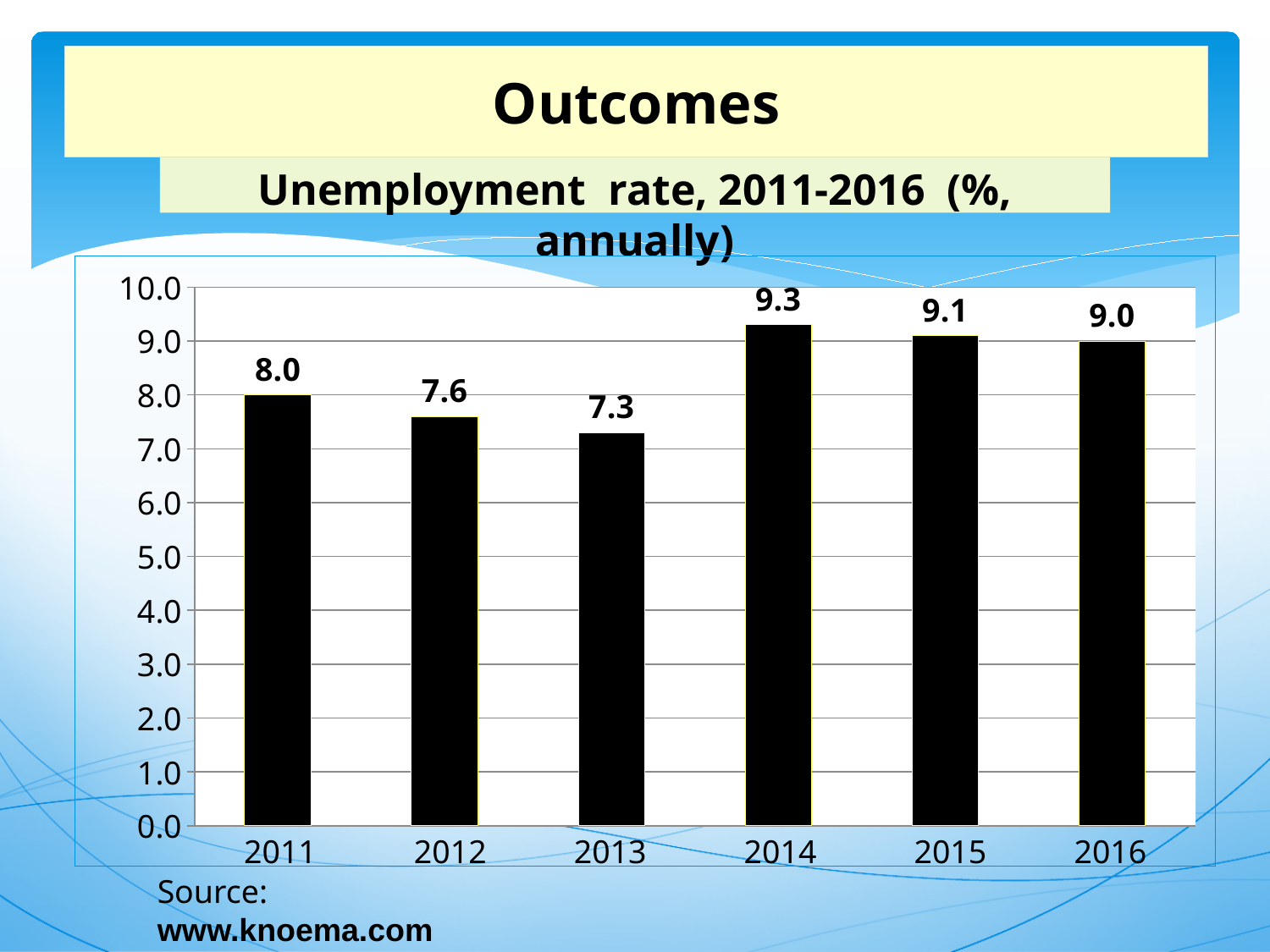
Which year has a higher unemployment rate, 2012 or 2015? 2015 Is the unemployment rate for 2013 greater or less than 8.0? less What is the unemployment rate for 2016? 9.0 What is the difference between the unemployment rate in 2014 and in 2013? 2.0 Did the unemployment rate rise or fall from 2011 to 2013? fall What is the unemployment rate for 2011? 8.0 Which year has the highest unemployment rate? 2014 What kind of chart is shown on the slide? bar chart How many years are shown on the chart? 6 What is the title of the chart? Unemployment rate, 2011-2016 (%, annually) Which year has the lowest unemployment rate? 2013 What is the unemployment rate for 2014? 9.3